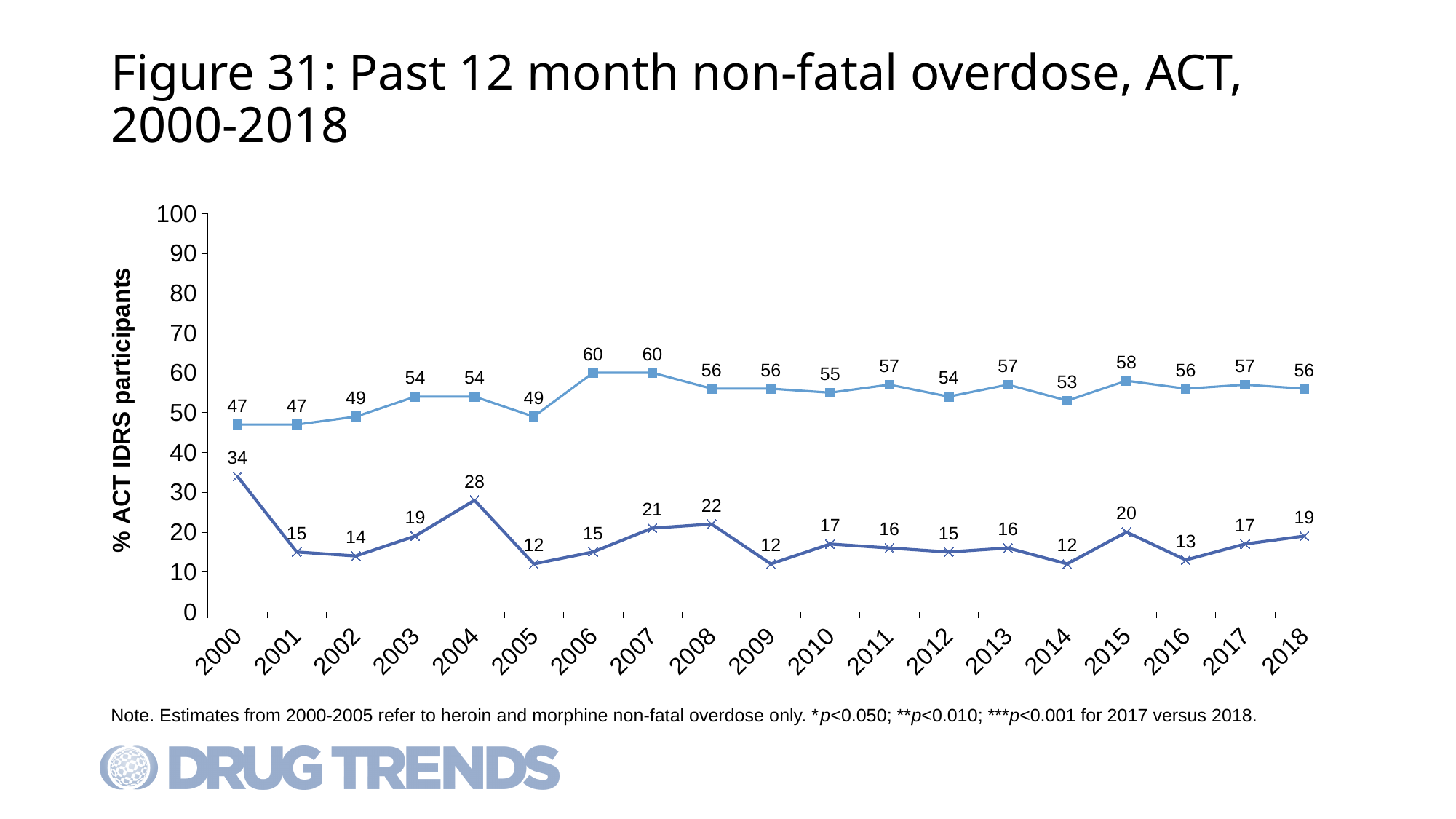
What is the value of the lower line (x markers) in 2018? 19 What type of chart is shown on the slide? Line chart What is the value of the upper line (square markers) in 2006? 60 Is the value of the upper line (square markers) in 2000 greater or less than 50? less What is the difference between the upper line and the lower line values in 2018? 37 Which is larger for the lower line (x markers): the value in 2007 or the value in 2009? 2007 What is the value of the lower line (x markers) in 2004? 28 In which year does the lower line (x markers) reach its highest value? 2000 How many lines (data series) are plotted on the chart? 2 What is the label of the y axis? % ACT IDRS participants What is the value of the upper line (square markers) in 2014? 53 How many years are plotted along the x axis? 19